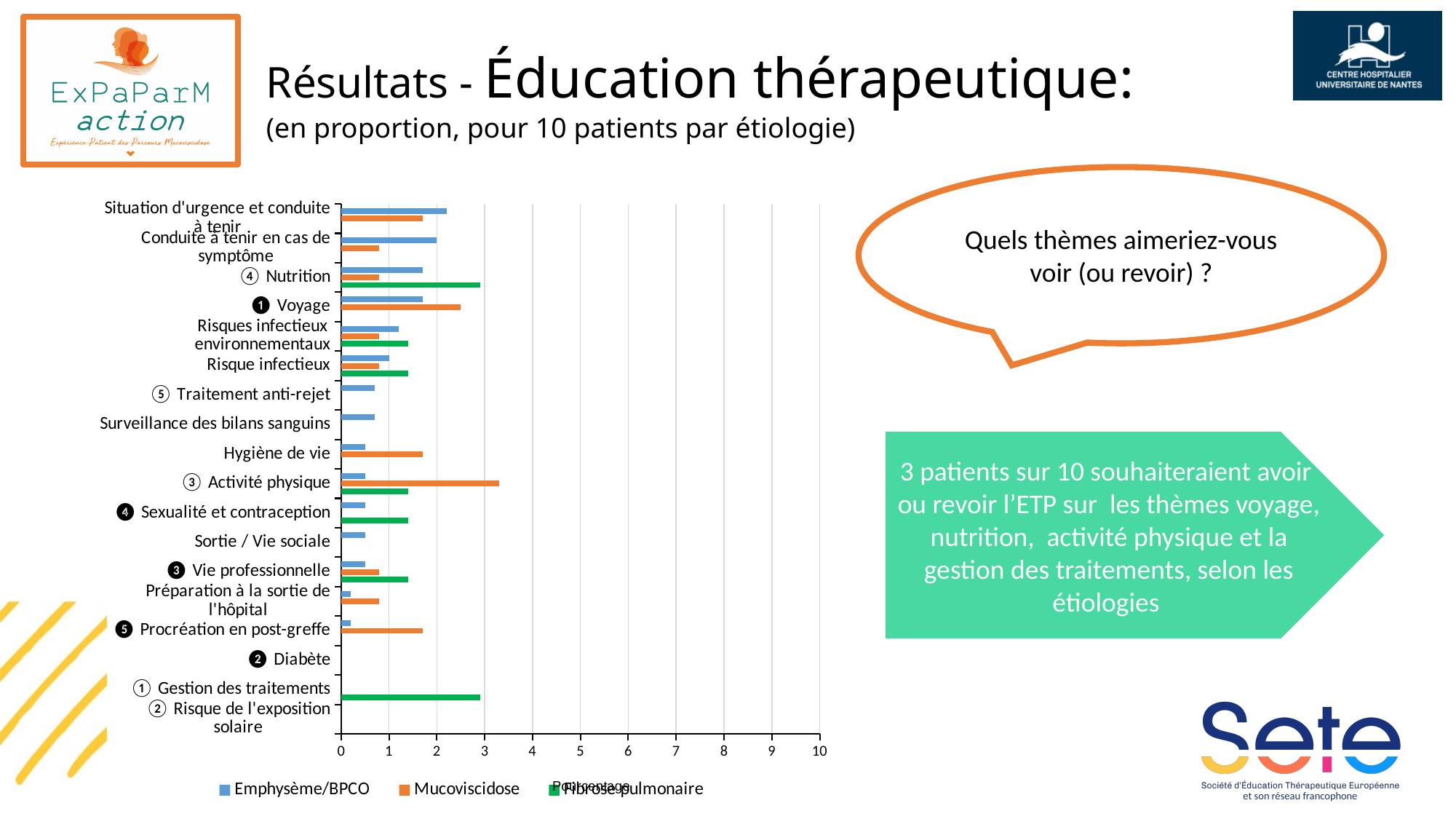
Is the Emphysème/BPCO value for Situation d'urgence et conduite à tenir greater or less than 2? greater Is the Mucoviscidose value for Voyage greater or less than 2? greater For Nutrition, which series has the larger value: Emphysème/BPCO or Fibrose pulmonaire? Fibrose pulmonaire For which category is the Mucoviscidose bar the longest? Activité physique Is the Mucoviscidose value for Activité physique greater or less than 3? greater How many series does the chart legend list? 3 For Activité physique, which series has the larger value: Emphysème/BPCO or Mucoviscidose? Mucoviscidose What kind of chart is shown on the slide? Bar chart Which three series are listed in the chart legend? Emphysème/BPCO, Mucoviscidose, Fibrose pulmonaire How many categories (themes) are plotted on the chart? 18